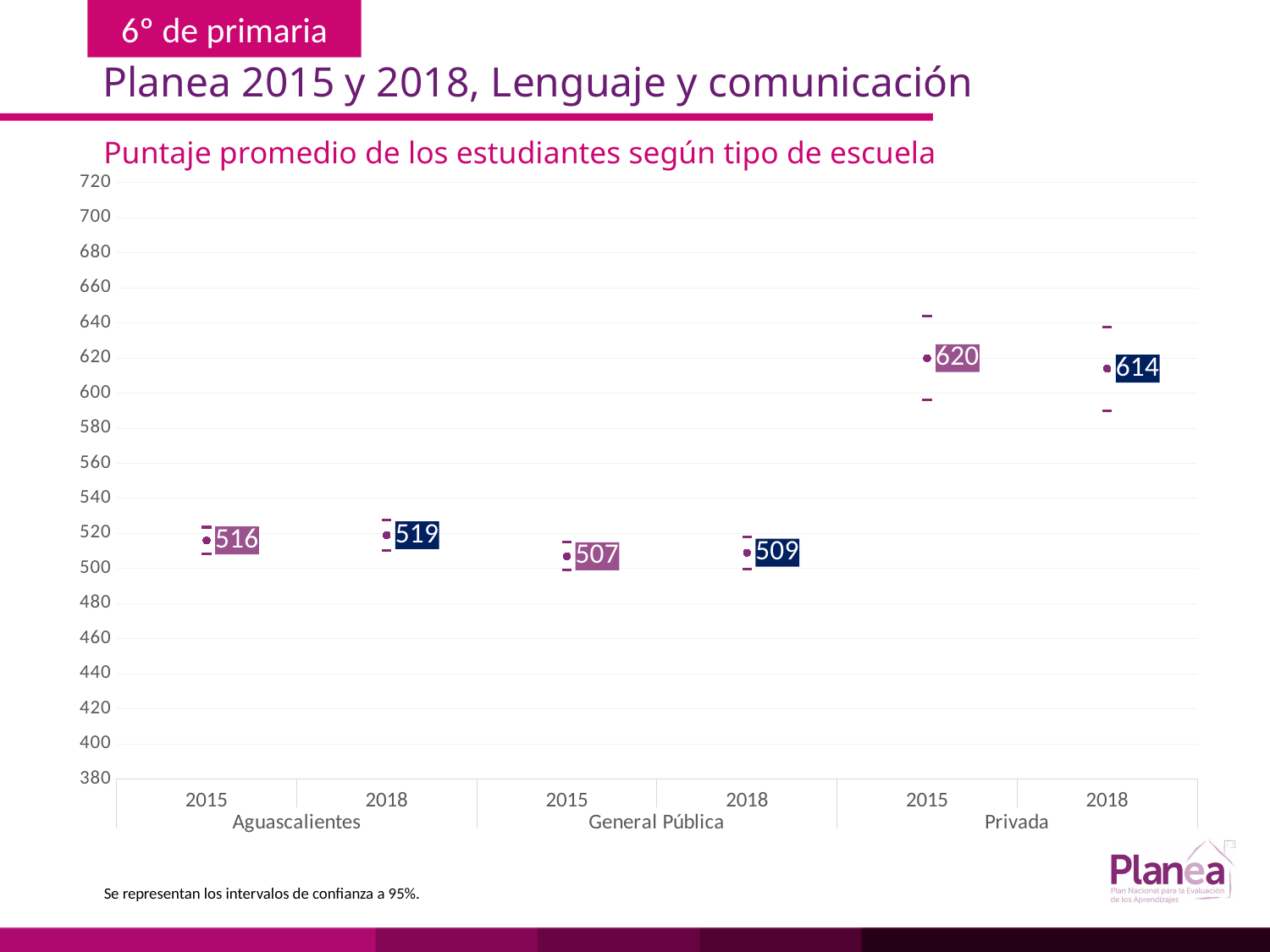
What is the title of the chart? Puntaje promedio de los estudiantes según tipo de escuela What is the average score for Aguascalientes in 2015? 516 What is the difference between the Privada scores in 2015 and 2018? 6 Which school type and year has the lowest average score? General Pública 2015 What is the average score for Privada in 2018? 614 Which school type and year has the highest average score? Privada 2015 What is the average score for General Pública in 2015? 507 What is the difference between the Aguascalientes score and the General Pública score in 2018? 10 Which is larger, the General Pública score in 2018 or the Aguascalientes score in 2015? Aguascalientes 2015 How many data points are plotted on the chart? 6 Did the Privada average score rise or fall from 2015 to 2018? Fall What is the average score for Aguascalientes in 2018? 519